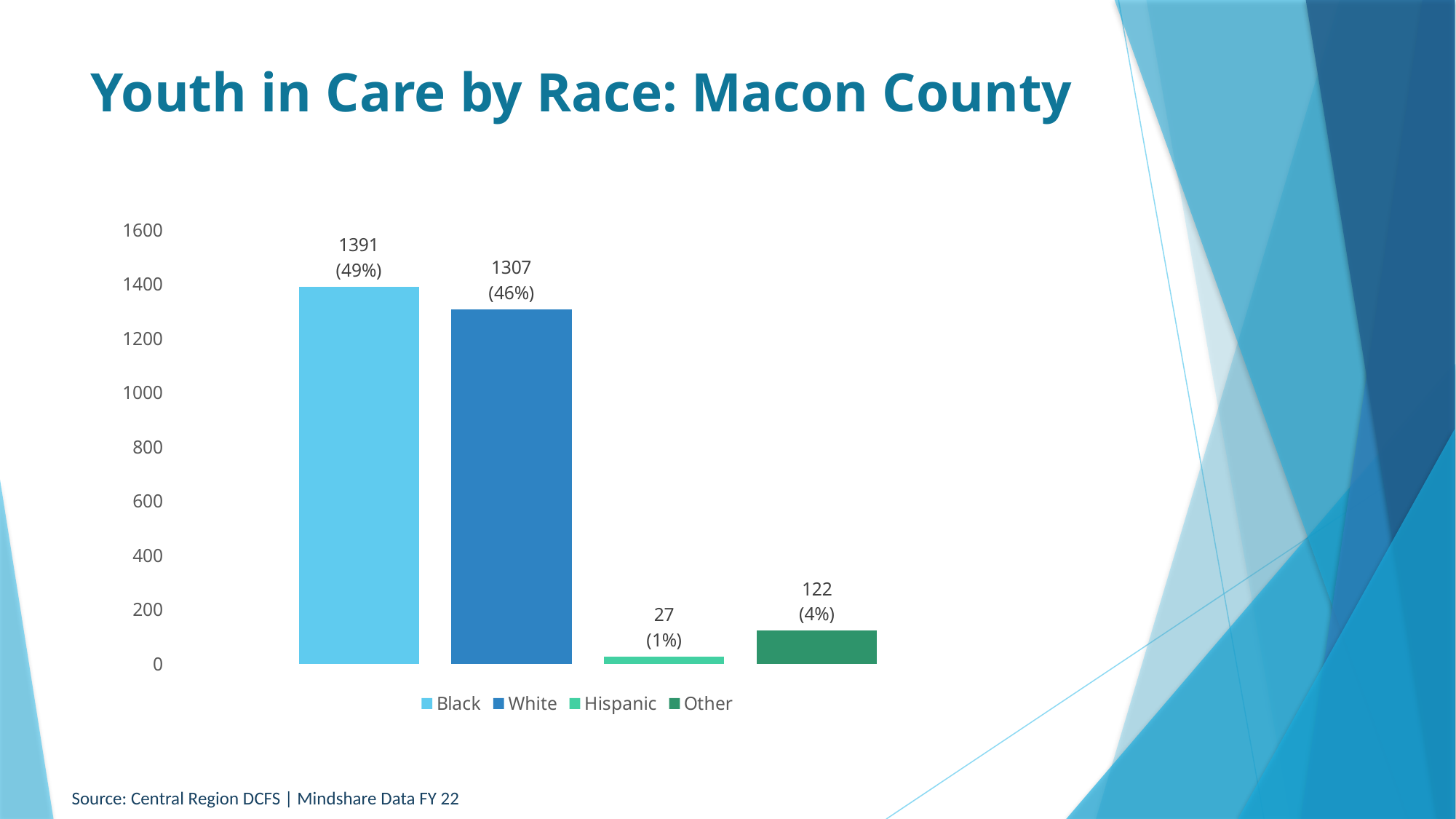
What is the difference between the Black and White values? 84 Which category has the lowest number of youth in care? Hispanic What is the difference between the Other and Hispanic values? 95 What is the title of the slide? Youth in Care by Race: Macon County What is the number of youth in care for Hispanic youth? 27 What is the number of youth in care for White youth? 1307 Which is larger, the value for White or the value for Other? White What kind of chart is shown on the slide? Bar chart Which category has the highest number of youth in care? Black What percentage is shown for the Other category? 4% How many categories are shown in the chart? 4 What is the number of youth in care for Black youth? 1391